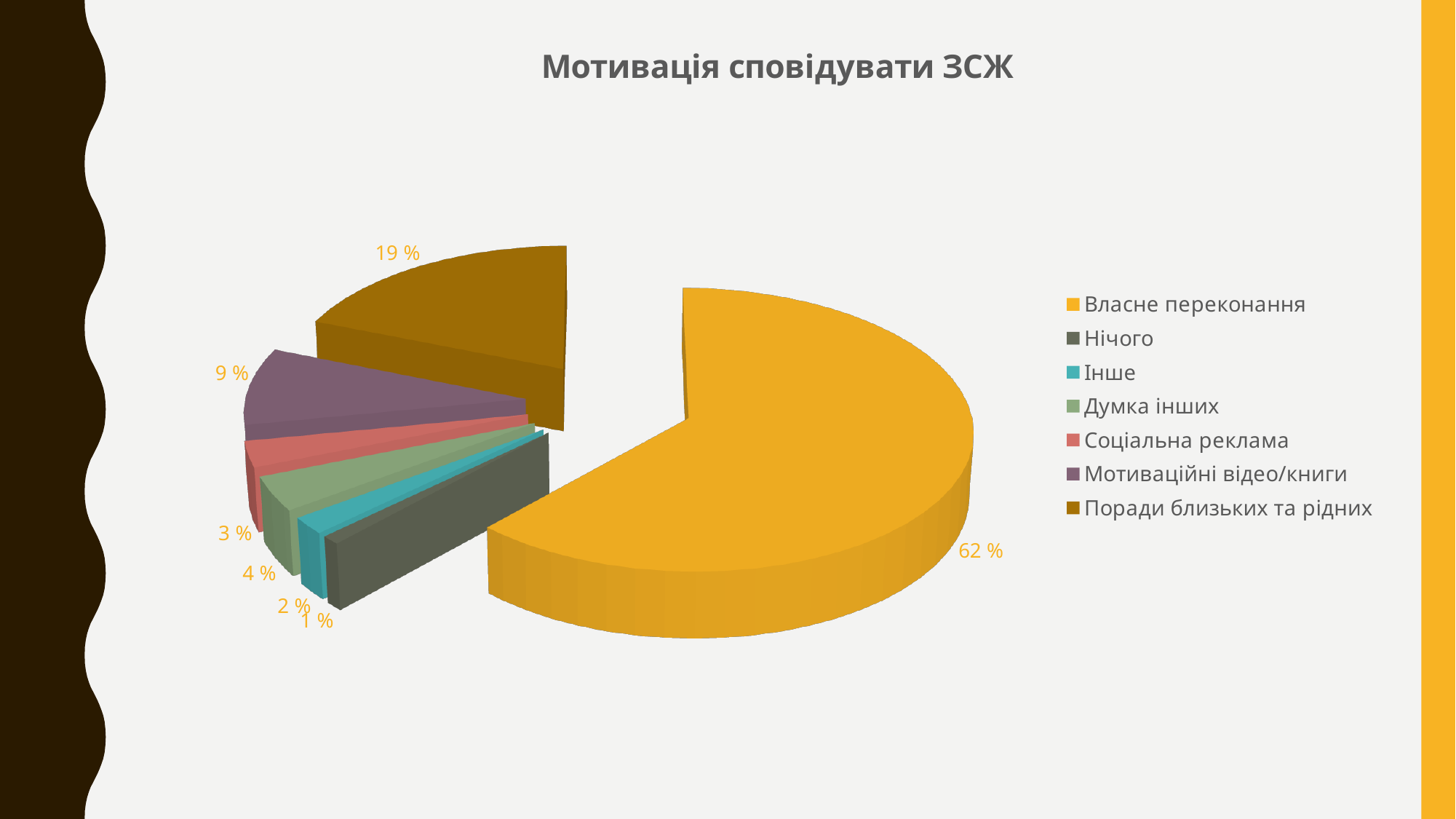
What is the value for Соціальна реклама? 3 % Which category has the smallest slice of the pie? Нічого What is the value for Думка інших? 4 % What is the value for Поради близьких та рідних? 19 % What share of the pie does Власне переконання have? 62 % What kind of chart is shown on the slide? pie chart What is the value for Мотиваційні відео/книги? 9 % What is the difference between the values for Власне переконання and Поради близьких та рідних? 43 % How many categories does the legend list? 7 Which category has the largest slice of the pie? Власне переконання Which is larger, the value for Інше or the value for Думка інших? Думка інших What is the title of the chart? Мотивація сповідувати ЗСЖ